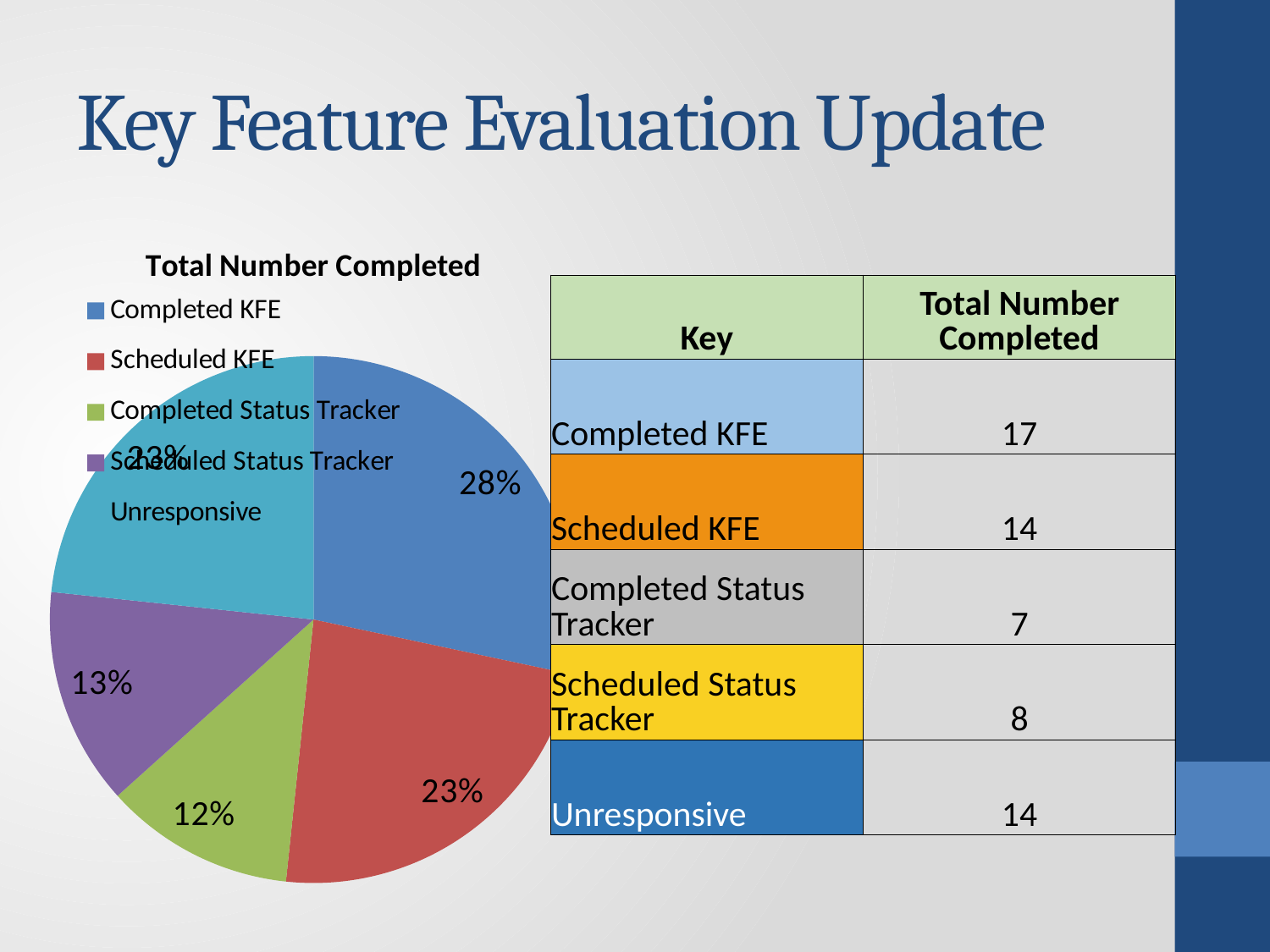
What kind of chart is shown on the slide? pie chart Which category has the largest slice of the pie? Completed KFE What share of the pie does Scheduled Status Tracker represent? 13% What share of the pie does Completed Status Tracker represent? 12% What is the difference in percentage points between the Completed KFE slice and the Completed Status Tracker slice? 16 Which slice is larger, Completed KFE or Scheduled KFE? Completed KFE What is the title of the pie chart? Total Number Completed What share of the pie does Completed KFE represent? 28% How many categories does the legend of the pie chart list? 5 Which category has the smallest slice of the pie? Completed Status Tracker Which colour is used for the Completed KFE slice in the pie chart? blue